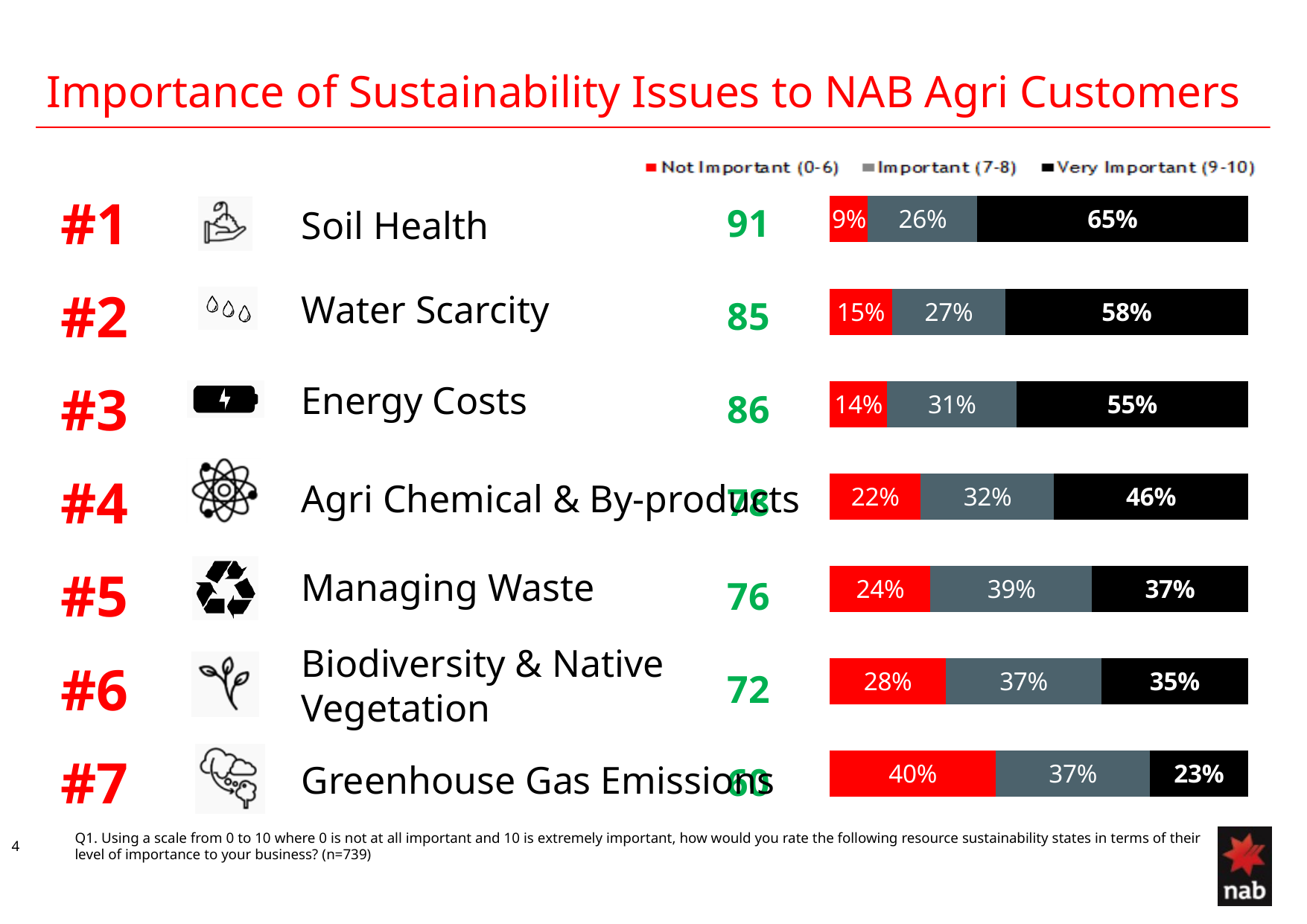
Which series in the legend is shown in red? Not Important (0-6) How many sustainability issues are plotted in the chart? 7 What is the Important (7-8) value for Managing Waste? 39% Which is larger: the Very Important (9-10) share for Managing Waste or for Biodiversity & Native Vegetation? Managing Waste Which issue has the highest Very Important (9-10) percentage? Soil Health What percentage of customers rated Soil Health as Very Important (9-10)? 65% What is the total of the Important (7-8) and Very Important (9-10) percentages for Agri Chemical & By-products? 78% What percentage of customers rated Greenhouse Gas Emissions as Not Important (0-6)? 40% Which issue has the lowest Not Important (0-6) percentage? Soil Health What kind of chart is shown on the slide? stacked bar chart What is the difference between the Very Important (9-10) percentages for Water Scarcity and Energy Costs? 3% How many series does the legend list? 3